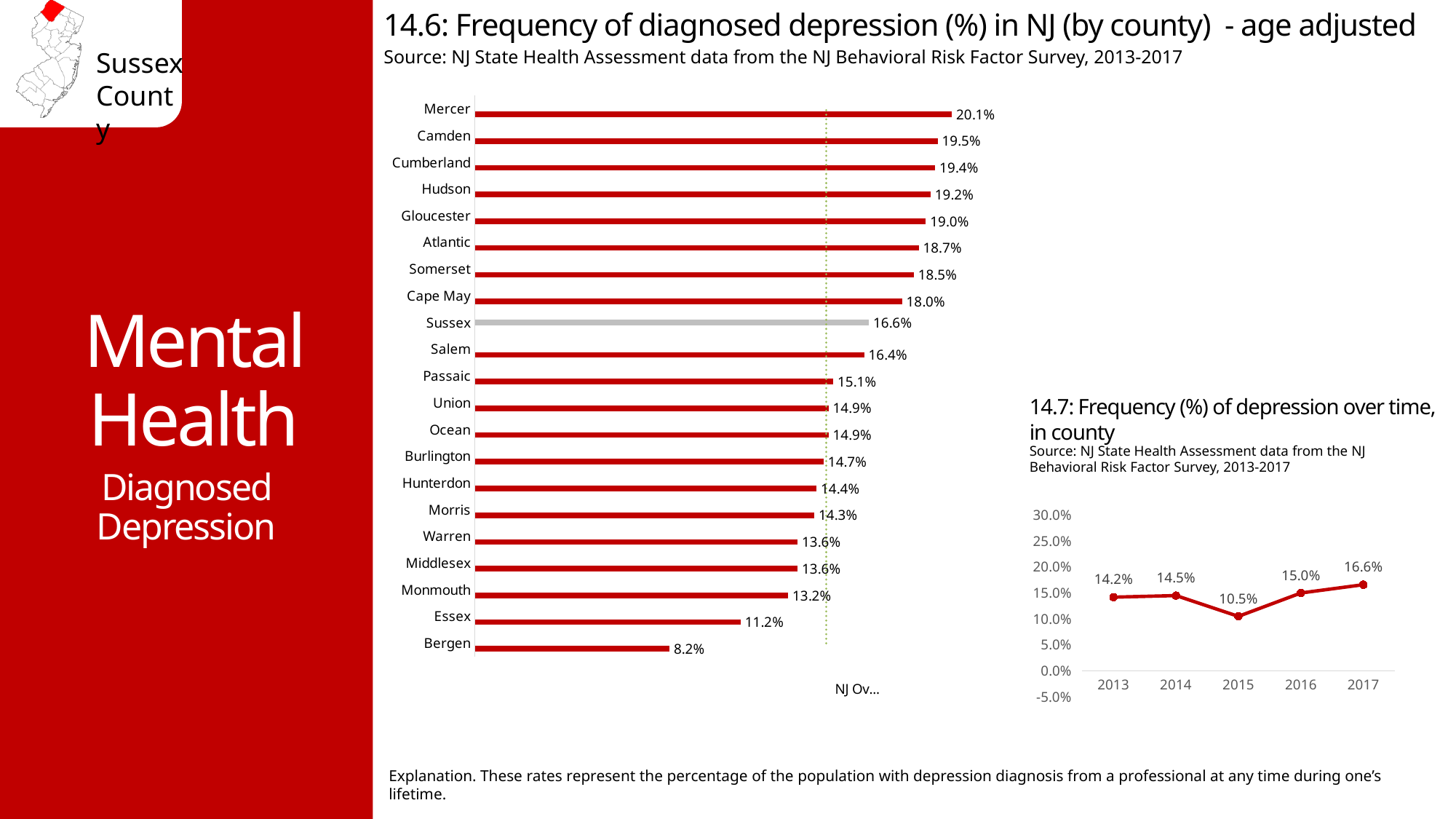
In the chart '14.6: Frequency of diagnosed depression (%) in NJ (by county) - age adjusted', which county has the lowest value? Bergen What kind of chart is '14.6: Frequency of diagnosed depression (%) in NJ (by county) - age adjusted'? Bar chart In the chart '14.6: Frequency of diagnosed depression (%) in NJ (by county) - age adjusted', what is the value for Essex? 11.2% In the chart '14.7: Frequency (%) of depression over time, in county', which year has the highest value? 2017 In the chart '14.6: Frequency of diagnosed depression (%) in NJ (by county) - age adjusted', what is the value for Sussex? 16.6% In the chart '14.7: Frequency (%) of depression over time, in county', what is the difference between the values for 2017 and 2013? 2.4% In the chart '14.6: Frequency of diagnosed depression (%) in NJ (by county) - age adjusted', what is the difference between the values for Mercer and Bergen? 11.9% In the chart '14.6: Frequency of diagnosed depression (%) in NJ (by county) - age adjusted', how many counties are shown? 21 In the chart '14.6: Frequency of diagnosed depression (%) in NJ (by county) - age adjusted', which is larger, the value for Hudson or the value for Gloucester? Hudson What kind of chart is '14.7: Frequency (%) of depression over time, in county'? Line chart In the chart '14.6: Frequency of diagnosed depression (%) in NJ (by county) - age adjusted', which county has the highest value? Mercer In the chart '14.7: Frequency (%) of depression over time, in county', what is the value for 2015? 10.5%